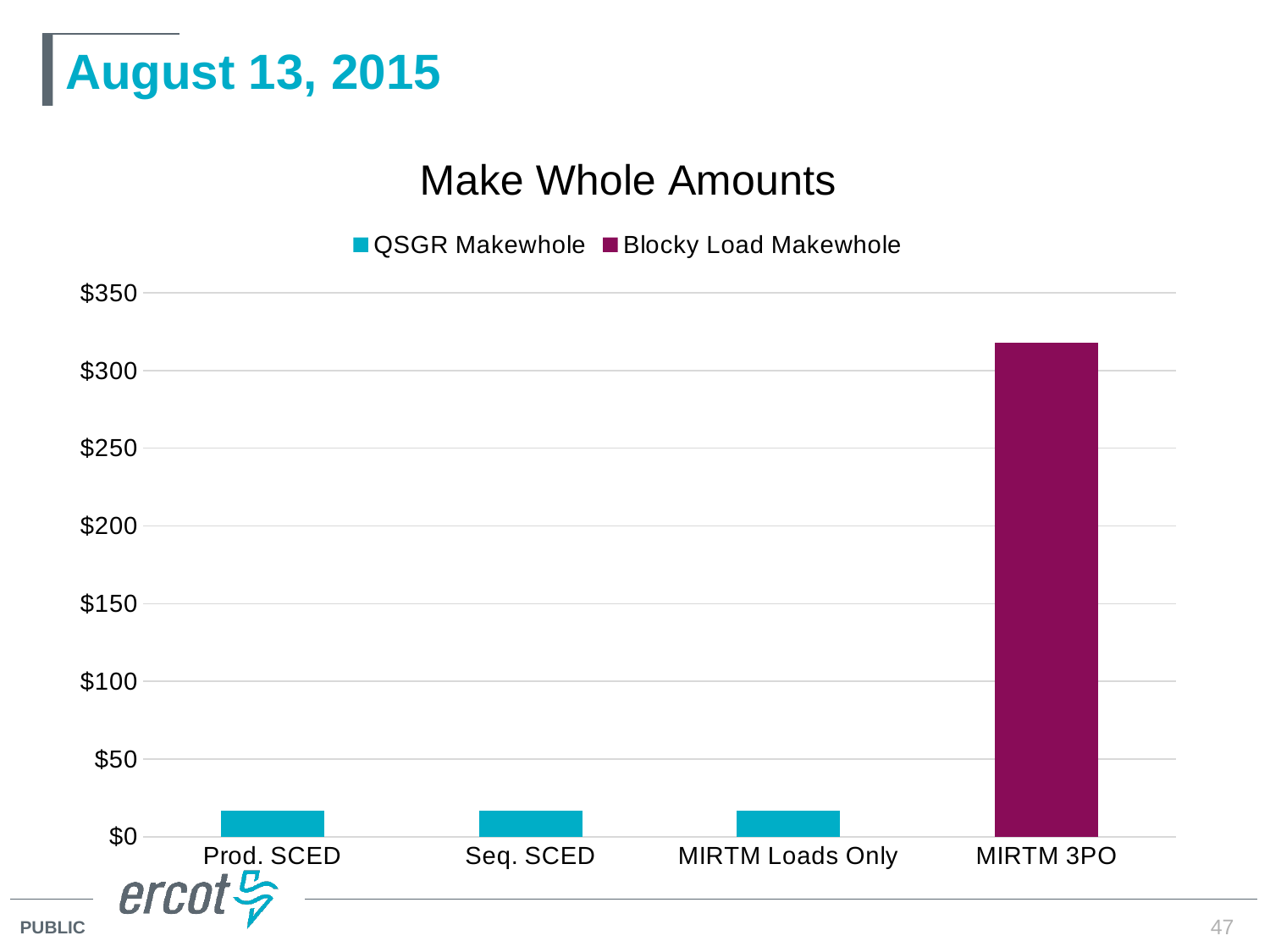
Is the value for MIRTM Loads Only greater or less than $100? less Which category has the highest bar? MIRTM 3PO Is the value for MIRTM 3PO greater or less than $350? less What are the two series named in the legend? QSGR Makewhole and Blocky Load Makewhole Is the value for Prod. SCED greater or less than $50? less Which is larger, the value for MIRTM 3PO or the value for Seq. SCED? MIRTM 3PO How many series does the legend list? 2 What type of chart is shown on the slide? bar chart What is the title of the chart? Make Whole Amounts Which category is the only one with a Blocky Load Makewhole bar? MIRTM 3PO How many categories are shown on the x axis? 4